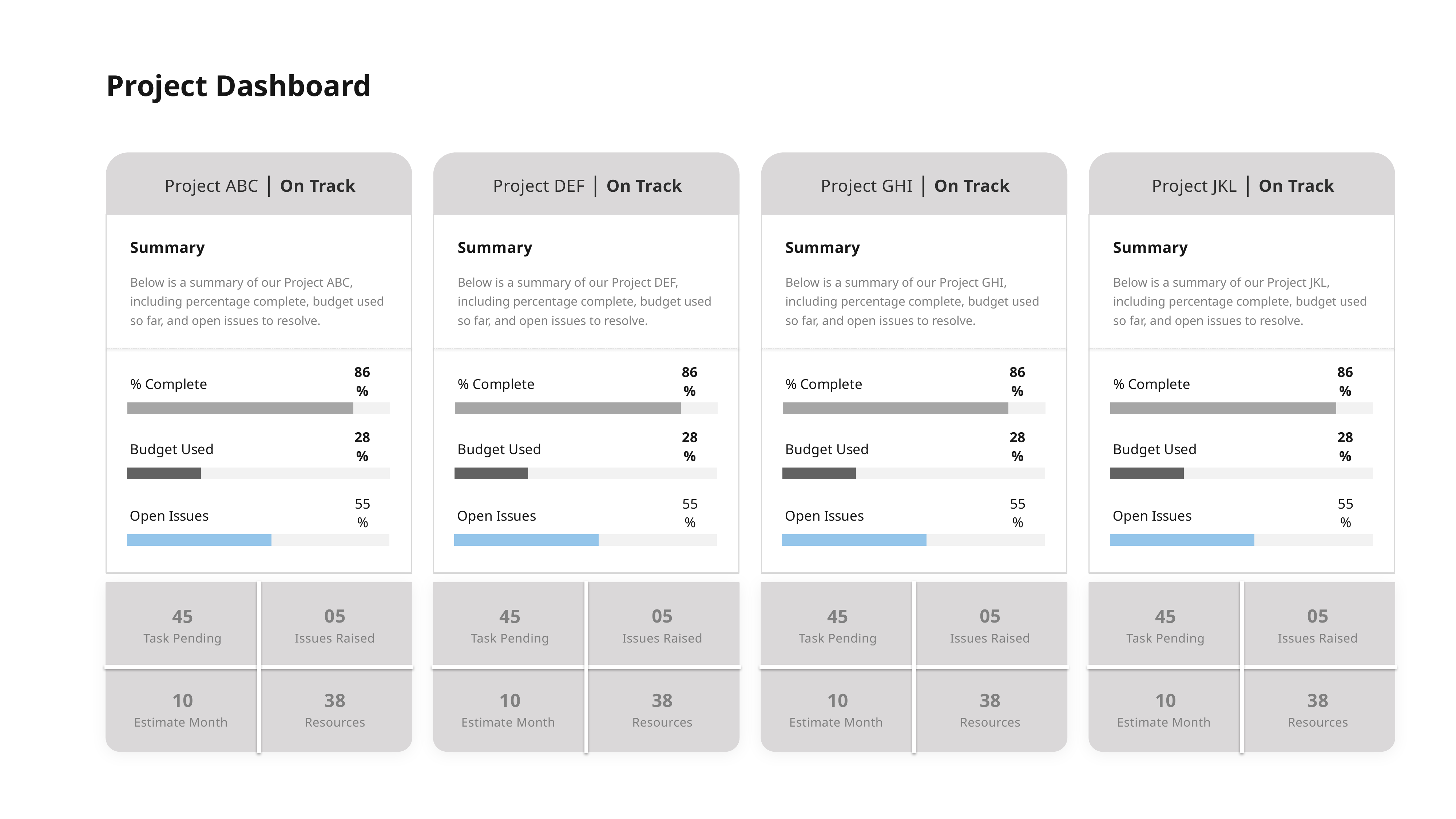
In the Project DEF card, what is the value shown for Budget Used? 28% In the Project GHI card, what is the difference between the Open Issues value and the Budget Used value? 27% In the Project JKL card, which of the three progress bars has the highest value? % Complete In the Project ABC card, what is the value shown for % Complete? 86% In the Project DEF card, what is the difference between the % Complete value and the Budget Used value? 58% In the Project JKL card, which is larger, the Open Issues value or the Budget Used value? Open Issues In the Project DEF card, what colour is the Open Issues bar? Blue In the Project GHI card, what is the value shown for Open Issues? 55% How many progress bars are shown in the Project ABC card? 3 What kind of chart is used to show % Complete, Budget Used and Open Issues in each project card? Bar chart In the Project ABC card, which of the three progress bars has the lowest value? Budget Used How many project cards are shown on the slide? 4